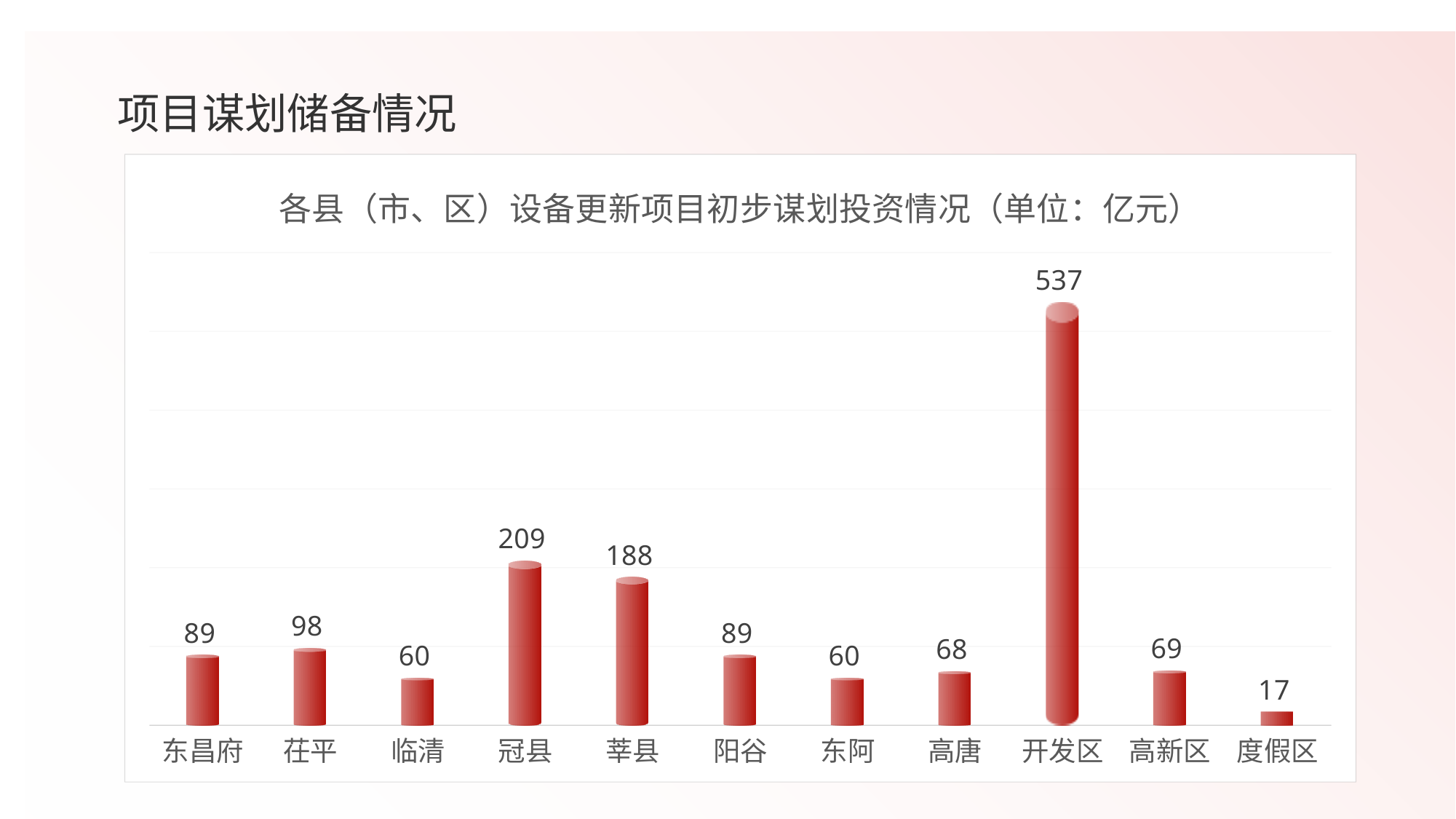
What is the difference between the values for 开发区 and 冠县? 328 What is the value for 高唐? 68 What kind of chart is this? bar chart What is the value for 冠县? 209 Which category has the lowest value? 度假区 How many categories are shown on the x axis? 11 What is the difference between the values for 冠县 and 莘县? 21 Which category has the highest value? 开发区 What is the value for 度假区? 17 Which is larger, the value for 茌平 or the value for 高新区? 茌平 What is the title of the chart? 各县（市、区）设备更新项目初步谋划投资情况（单位：亿元） What is the value for 开发区? 537